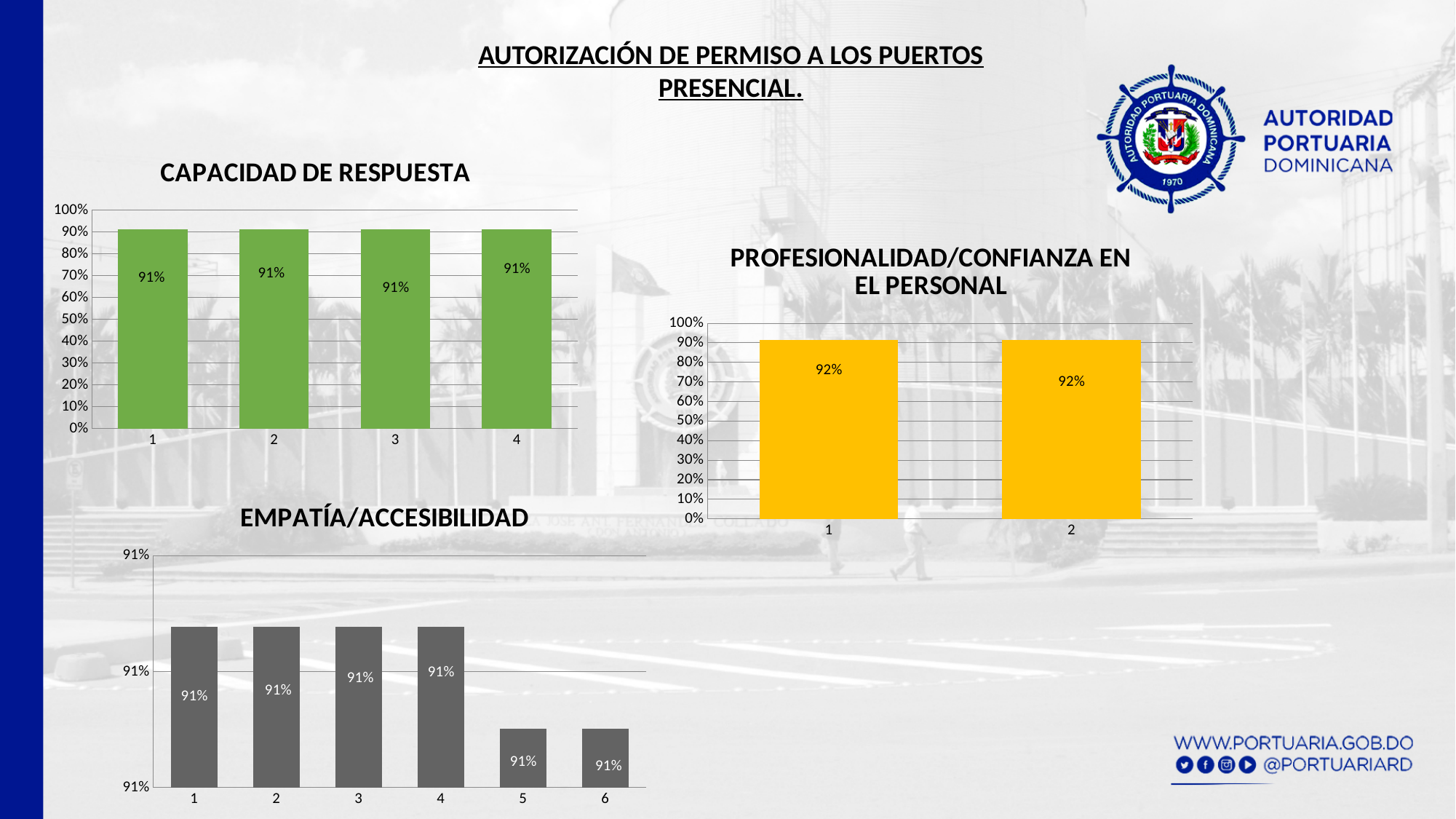
What kind of chart is CAPACIDAD DE RESPUESTA? bar chart In the CAPACIDAD DE RESPUESTA chart, what is the value for category 1? 91% In the CAPACIDAD DE RESPUESTA chart, is the value for category 2 greater or less than 50%? greater How many bars are plotted in the CAPACIDAD DE RESPUESTA chart? 4 How many bars are plotted in the PROFESIONALIDAD/CONFIANZA EN EL PERSONAL chart? 2 In the PROFESIONALIDAD/CONFIANZA EN EL PERSONAL chart, what is the value for category 1? 92% In the PROFESIONALIDAD/CONFIANZA EN EL PERSONAL chart, is the value for category 1 greater or less than 80%? greater What colour are the bars in the PROFESIONALIDAD/CONFIANZA EN EL PERSONAL chart? yellow In the EMPATÍA/ACCESIBILIDAD chart, what is the value labelled on the bar for category 3? 91% In the PROFESIONALIDAD/CONFIANZA EN EL PERSONAL chart, what is the value for category 2? 92% In the CAPACIDAD DE RESPUESTA chart, what is the value for category 4? 91% How many bars are plotted in the EMPATÍA/ACCESIBILIDAD chart? 6